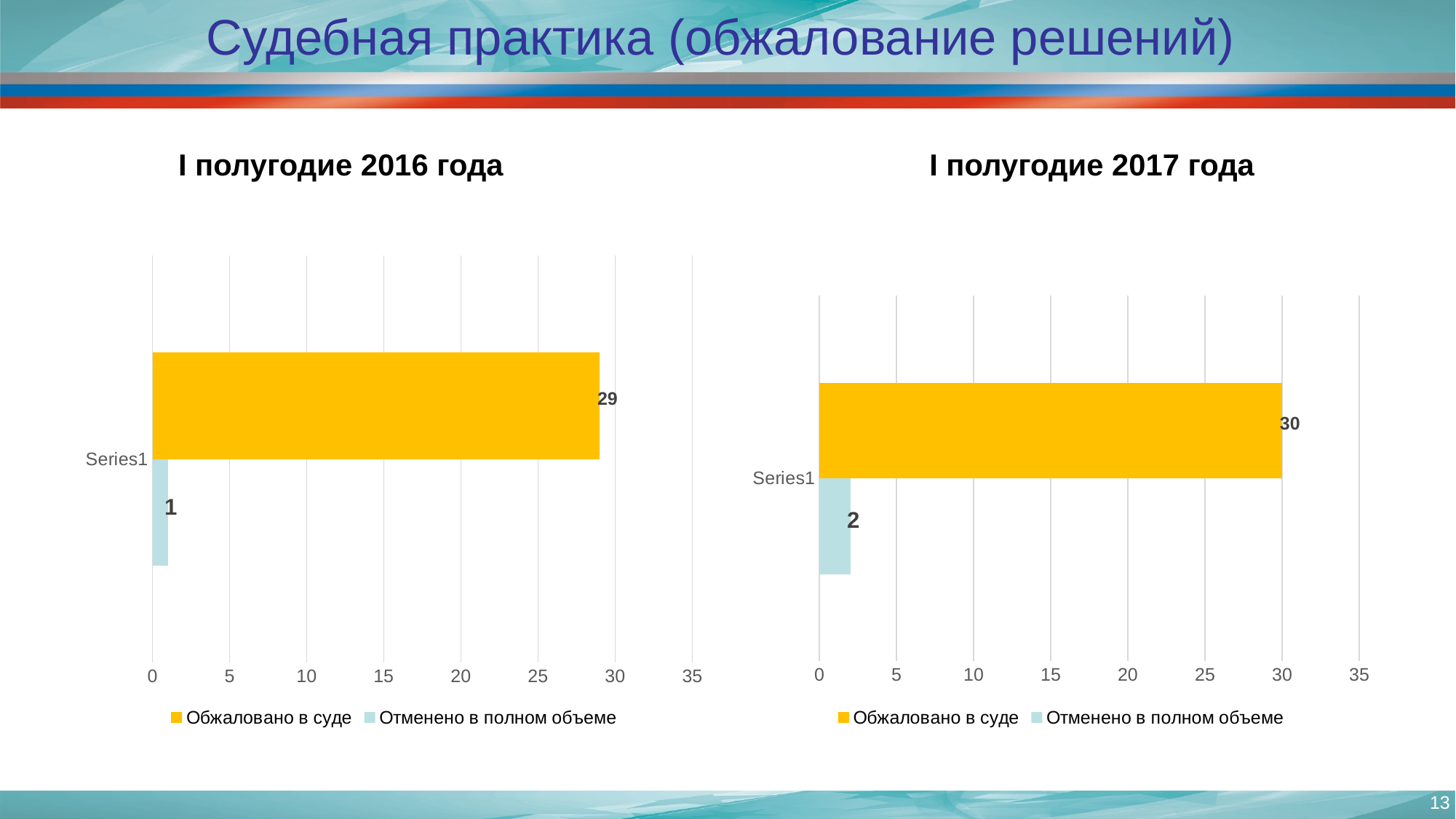
In the 'I полугодие 2017 года' chart, which series has the higher value? Обжаловано в суде Which is larger: 'Обжаловано в суде' in the 'I полугодие 2016 года' chart or 'Обжаловано в суде' in the 'I полугодие 2017 года' chart? I полугодие 2017 года In the 'I полугодие 2017 года' chart, what is the value for 'Обжаловано в суде'? 30 In the 'I полугодие 2016 года' chart, what is the value for 'Отменено в полном объеме'? 1 In the 'I полугодие 2016 года' chart, what is the difference between 'Обжаловано в суде' and 'Отменено в полном объеме'? 28 In the 'I полугодие 2017 года' chart, what is the value for 'Отменено в полном объеме'? 2 In the 'I полугодие 2016 года' chart, is the value for 'Обжаловано в суде' greater or less than 25? greater What kind of chart is the 'I полугодие 2016 года' chart? bar chart In the 'I полугодие 2016 года' chart, what is the value for 'Обжаловано в суде'? 29 In the 'I полугодие 2017 года' chart, what is the difference between 'Обжаловано в суде' and 'Отменено в полном объеме'? 28 How many series does the legend of the 'I полугодие 2017 года' chart list? 2 In the 'I полугодие 2016 года' chart, which series has the lowest value? Отменено в полном объеме